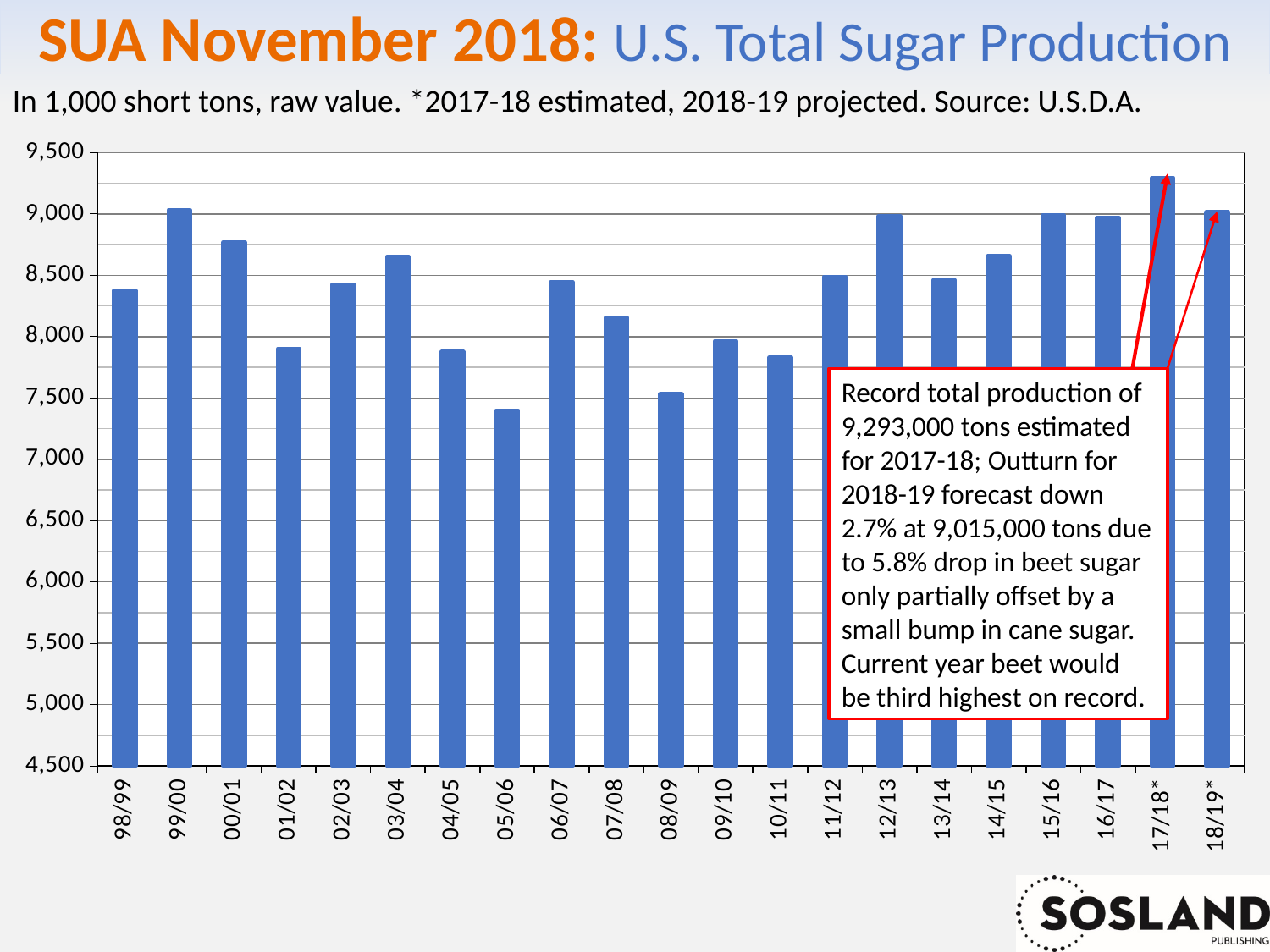
Does production rise or fall from 05/06 to 06/07? rise Which crop year has the lowest U.S. total sugar production? 05/06 How many crop years (bars) are plotted on the chart? 21 What kind of chart is shown on the slide? bar chart According to the annotation on the chart, what is the record total production estimated for 2017-18? 9,293,000 tons According to the annotation on the chart, what is the projected total production for 2018-19? 9,015,000 tons Is the value for 14/15 greater or less than 8,500? greater In what units is production expressed, according to the subtitle? 1,000 short tons, raw value Which is larger, the production in 99/00 or in 00/01? 99/00 Which crop year has the highest U.S. total sugar production? 17/18* Is the value for 98/99 greater or less than 8,500? less Is the value for 10/11 greater or less than 8,000? less